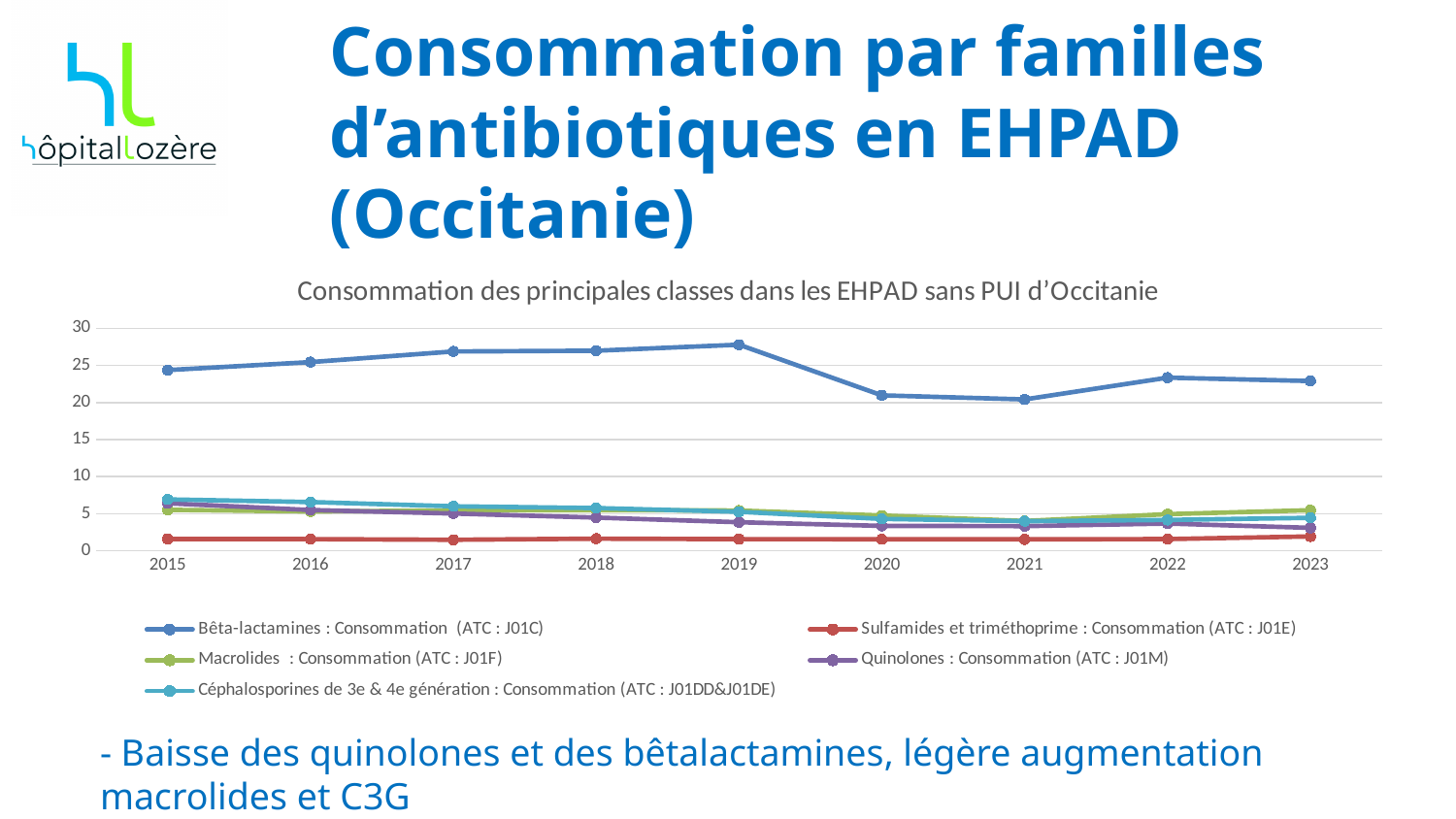
What kind of chart is shown on the slide? line chart Is the value for Bêta-lactamines in 2020 greater or less than 25? less How many series does the legend list? 5 Do the values for Quinolones rise or fall from 2015 to 2023? fall What is the title of the chart? Consommation des principales classes dans les EHPAD sans PUI d’Occitanie Is the value for Bêta-lactamines in 2019 greater or less than 25? greater How many years are plotted along the x axis? 9 Which series has the lowest value in 2015? Sulfamides et triméthoprime : Consommation (ATC : J01E) In 2015, which is larger: the value for Bêta-lactamines or the value for Macrolides? Bêta-lactamines Is the value for Sulfamides et triméthoprime in 2015 greater or less than 5? less Which series has the highest values across all years? Bêta-lactamines : Consommation (ATC : J01C) In which year does the Bêta-lactamines series reach its highest value? 2019